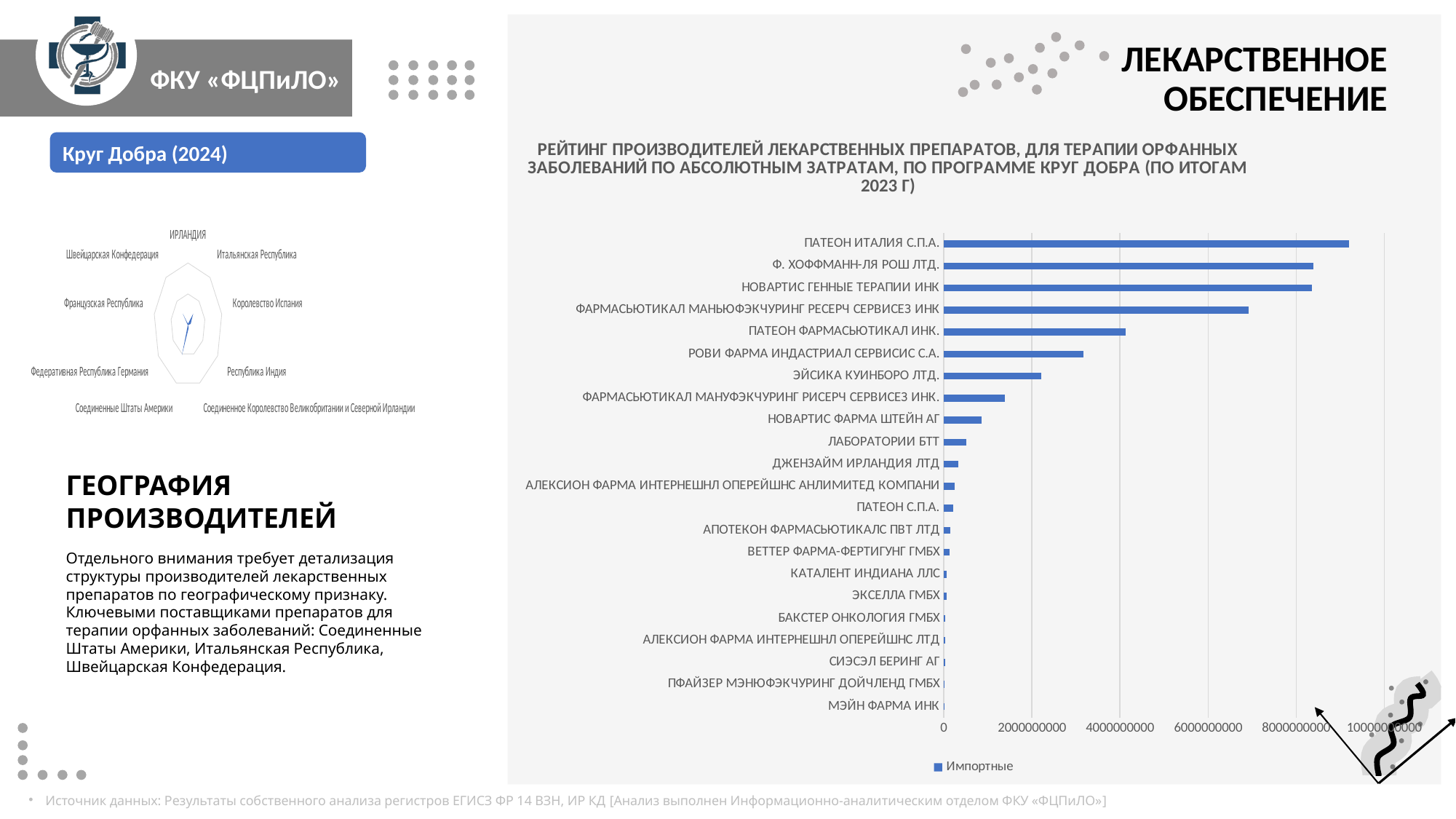
What type of chart is the chart on the left under 'Круг Добра (2024)' showing countries such as ИРЛАНДИЯ and Республика Индия? Radar chart In the bar chart on the right, which is larger: the value for НОВАРТИС ФАРМА ШТЕЙН АГ or for ЛАБОРАТОРИИ БТТ? НОВАРТИС ФАРМА ШТЕЙН АГ What is the legend entry of the bar chart on the right? Импортные In the bar chart on the right, which is larger: the value for ПАТЕОН ФАРМАСЬЮТИКАЛ ИНК. or for РОВИ ФАРМА ИНДАСТРИАЛ СЕРВИСИС С.А.? ПАТЕОН ФАРМАСЬЮТИКАЛ ИНК. In the bar chart on the right, is the value for ФАРМАСЬЮТИКАЛ МАНЬЮФЭКЧУРИНГ РЕСЕРЧ СЕРВИСЕЗ ИНК greater or less than 6000000000? greater How many manufacturers are listed in the bar chart on the right? 22 How many countries are shown as categories in the radar chart on the left? 9 In the bar chart on the right, is the value for ПАТЕОН ИТАЛИЯ С.П.А. greater or less than 8000000000? greater In the bar chart on the right, which manufacturer has the highest value? ПАТЕОН ИТАЛИЯ С.П.А. What type of chart is the chart on the right titled 'РЕЙТИНГ ПРОИЗВОДИТЕЛЕЙ ЛЕКАРСТВЕННЫХ ПРЕПАРАТОВ...'? Bar chart In the bar chart on the right, is the value for РОВИ ФАРМА ИНДАСТРИАЛ СЕРВИСИС С.А. greater or less than 4000000000? less How many series does the legend of the bar chart on the right list? 1